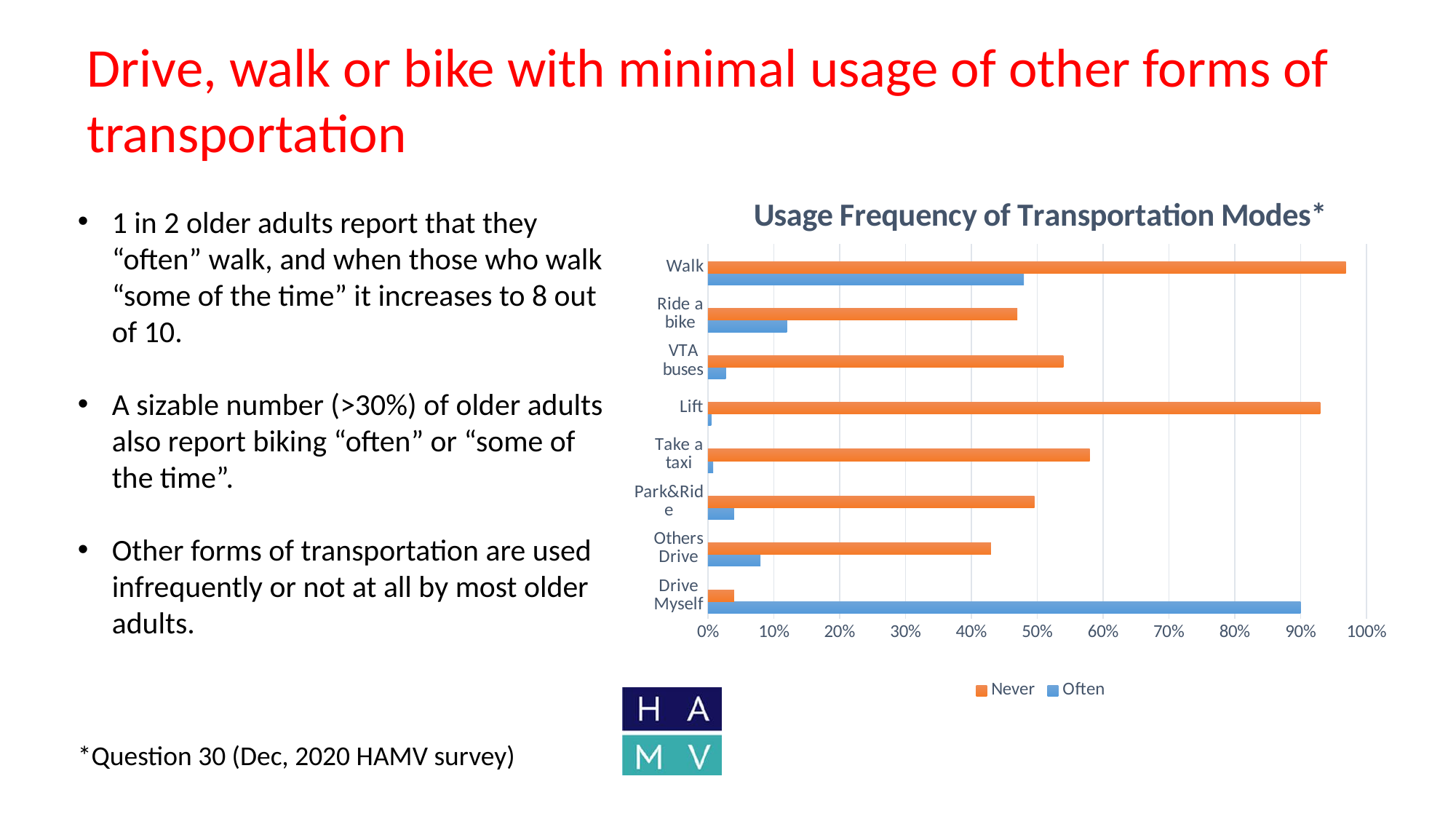
Which transportation mode has the highest "Often" value? Drive Myself What is the title of the chart? Usage Frequency of Transportation Modes* How many series does the chart legend list? 2 How many transportation modes are shown on the chart? 8 Which transportation mode has the highest "Never" value? Walk Which colour represents the "Never" series in the chart? orange Is the "Never" value for Walk greater or less than 90%? greater Is the "Often" value for Drive Myself greater or less than 80%? greater Which is larger: the "Often" value for Walk or the "Often" value for Ride a bike? Walk Is the "Often" value for Ride a bike greater or less than 20%? less Which transportation mode has the lowest "Never" value? Drive Myself What kind of chart is shown on the slide? bar chart